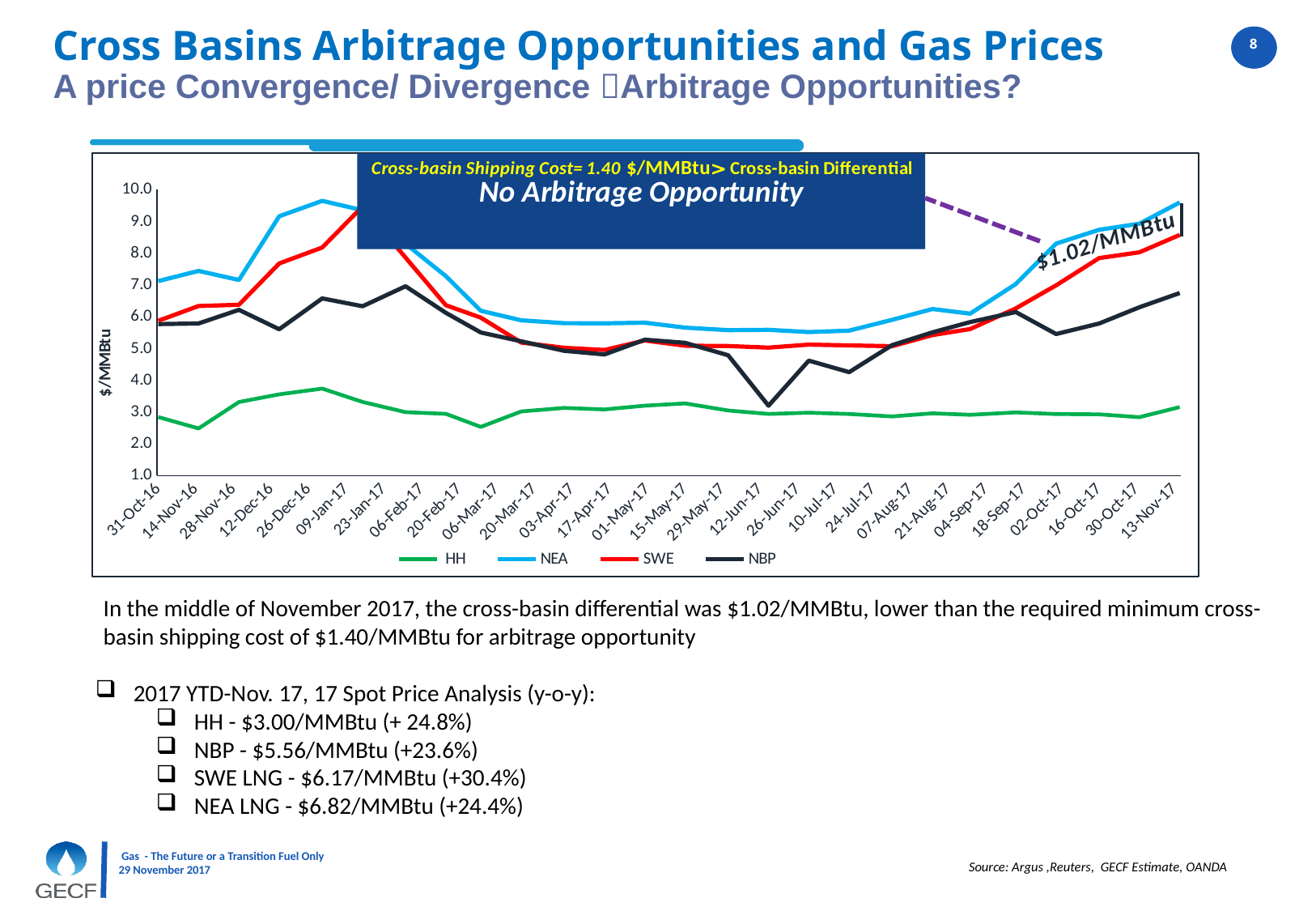
Is the value for NBP on 12-Jun-17 greater or less than 4.0? less Which series has the highest value on 09-Jan-17? NEA What kind of chart is shown on the slide? line chart Does the NEA series rise or fall between 09-Jan-17 and 12-Jun-17? fall How many dates are labelled along the x axis of the chart? 28 Is the value for SWE on 13-Nov-17 greater or less than 8.0? greater Which series has the lowest value on 13-Nov-17? HH Which series are listed in the chart's legend? HH, NEA, SWE, NBP What cross-basin differential value is annotated at the right end of the chart? $1.02/MMBtu How many series does the chart's legend list? 4 Is the value for NEA on 09-Jan-17 greater or less than 9.0? greater